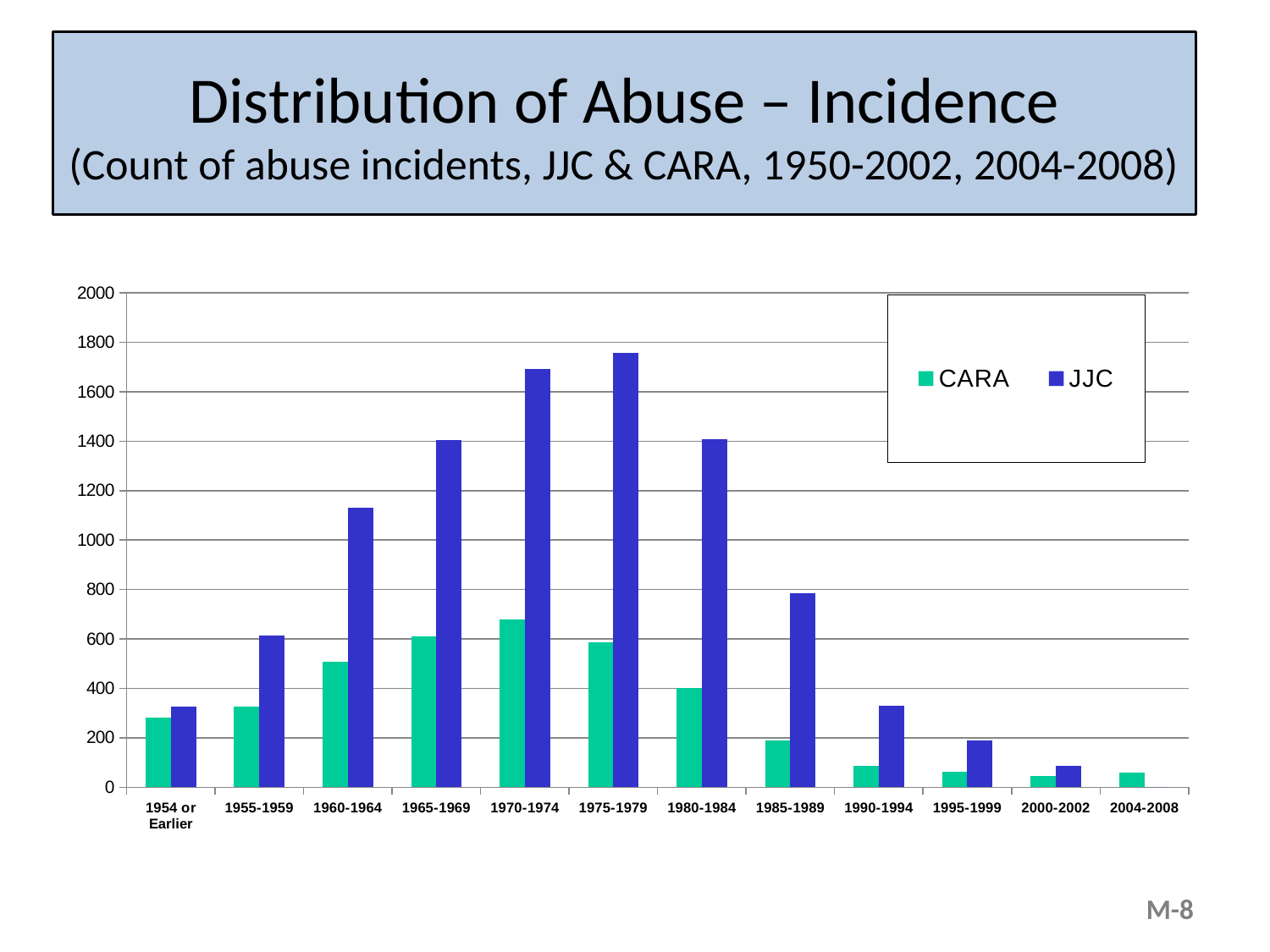
Is the JJC value for 1990-1994 greater or less than 400? less Which time period has the highest JJC value? 1975-1979 How many series does the legend list? 2 Which is larger, the CARA value for 1960-1964 or the CARA value for 1980-1984? 1960-1964 What kind of chart is shown on the slide? bar chart For 1965-1969, which series has the larger value, CARA or JJC? JJC How many time-period categories are shown on the x axis? 12 Is the JJC value for 1970-1974 greater or less than 1600? greater Which time period has the highest CARA value? 1970-1974 Do the JJC values rise or fall from 1975-1979 through 2000-2002? fall Is the JJC value for 1960-1964 greater or less than 1000? greater